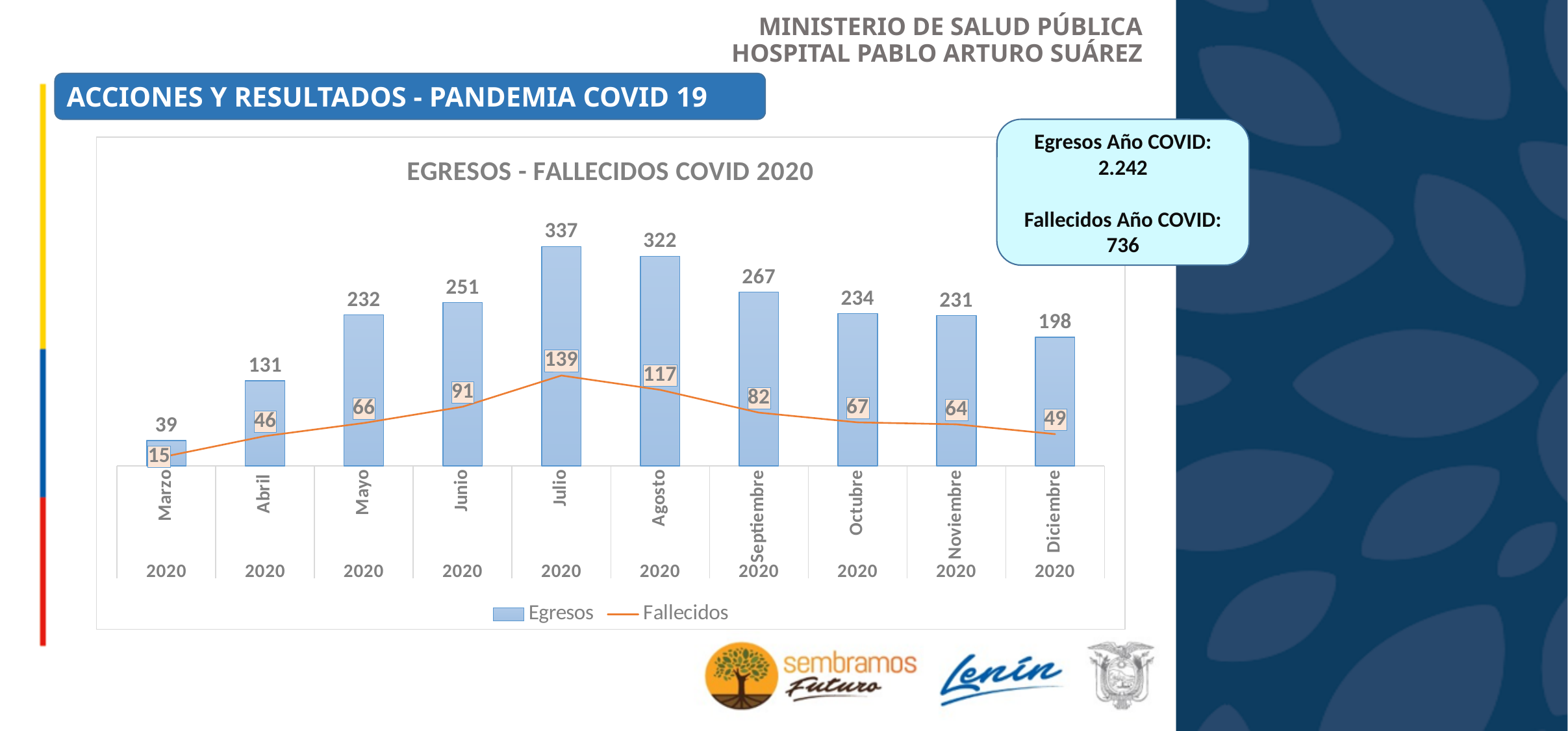
What is the difference between the Egresos values for Julio and Agosto? 15 What is the title of the chart? EGRESOS - FALLECIDOS COVID 2020 What is the Egresos value for Marzo 2020? 39 What is the Fallecidos value for Agosto 2020? 117 Do the Egresos values rise or fall from Agosto to Diciembre? Fall What is the Egresos value for Julio 2020? 337 How many months are shown on the x axis? 10 Which month has the lowest Fallecidos value? Marzo How many series does the legend list? 2 Which month has the highest Egresos value? Julio What kind of chart is used for the Egresos series? Bar chart Which is larger, the Fallecidos value for Octubre or for Noviembre? Octubre